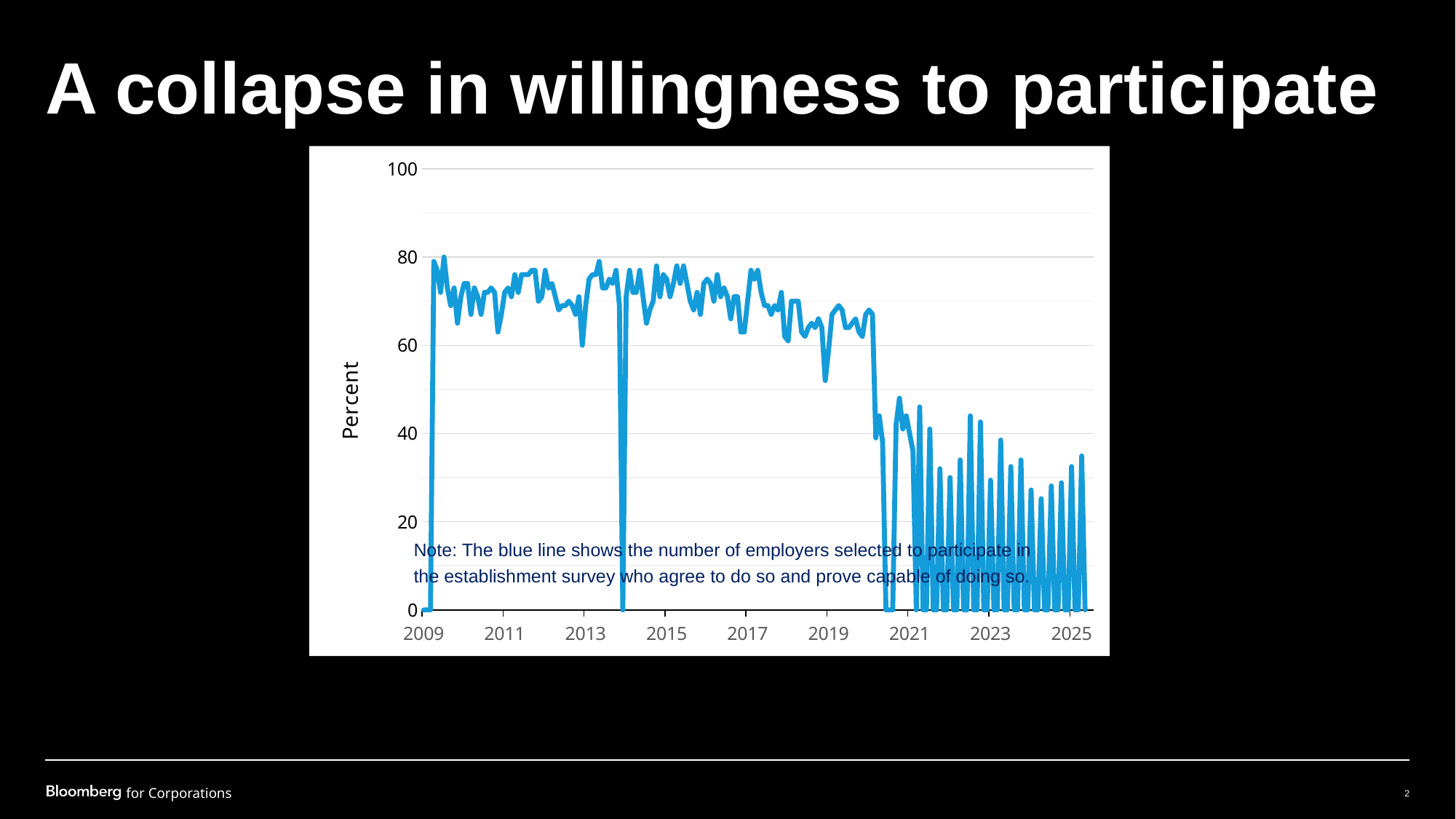
Is the value for 2017 greater or less than 80? less Are the peak values in 2024 greater or less than 60? less Is the value for 2011 greater or less than 40? greater What is the title of the slide containing the chart? A collapse in willingness to participate How many year labels are shown on the x axis? 9 What kind of chart is shown on the slide? line chart What is the highest value shown on the y axis? 100 Overall, do the values rise or fall along the x axis from 2009 to 2025? fall What is the label on the vertical axis of the chart? Percent